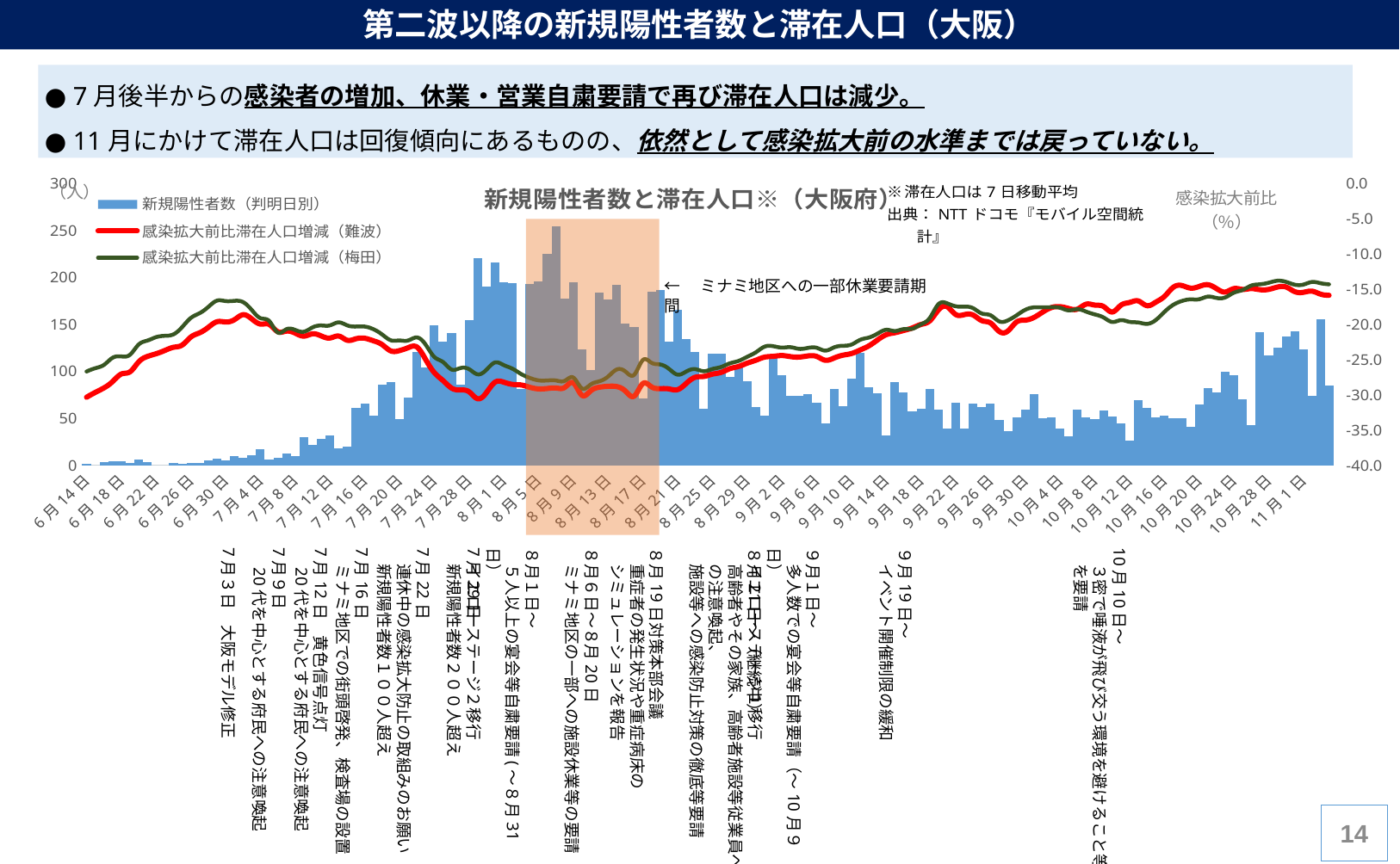
Do the 新規陽性者数 bars generally rise or fall from 6月14日 to 8月9日? rise At 6月30日, which line is higher: 難波 or 梅田? 梅田 Do the 難波 and 梅田 lines generally rise or fall from 7月4日 to 8月13日? fall In which month does the tallest 新規陽性者数 bar occur? 8月 Is the 感染拡大前比滞在人口増減（難波） line at 8月13日 greater or less than -25.0? less Do the 難波 and 梅田 lines generally rise or fall from 8月21日 to 11月1日? rise Is the 感染拡大前比滞在人口増減（梅田） line at 6月30日 greater or less than -20.0? greater Which series is drawn as blue bars according to the legend? 新規陽性者数（判明日別） How many series does the chart legend list? 3 Is the value of the 新規陽性者数 bar for 6月14日 greater or less than 50? less What kind of chart is shown on the slide? A combined bar and line chart What is the title of the chart? 新規陽性者数と滞在人口※（大阪府）